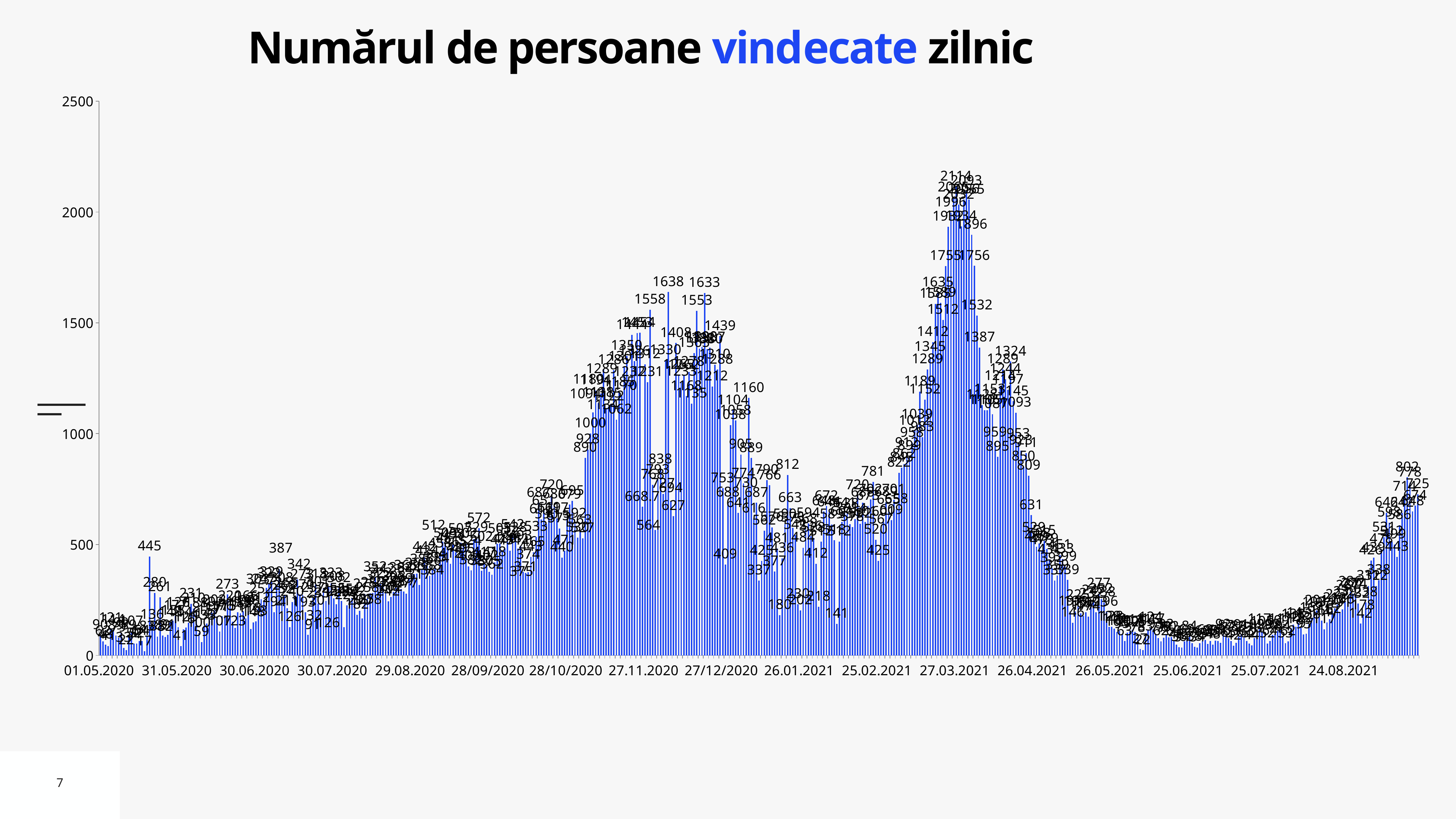
How many date labels are shown on the x axis? 17 What is the value of the tall isolated spike just before 31.05.2020? 445 What is the highest daily value labeled on the chart? 2114 Are the values around 25.06.2021 greater or less than 500? less What is the title of the chart? Numărul de persoane vindecate zilnic Which is larger: the peak of the wave around 27.03.2021 or the peak of the wave around 27.11.2020? the peak around 27.03.2021 What kind of chart is shown on the slide? bar chart Is the peak value near 27.03.2021 greater or less than 2000? greater Do the values rise or fall between 27.03.2021 and 26.05.2021? fall What is the value of the isolated spike between 30.06.2020 and 30.07.2020? 387 What is the difference between the highest value, 2114, and the bar labeled 1638 in the November 2020 wave? 476 Around which x-axis date label does the tallest bar (2114) occur? 27.03.2021